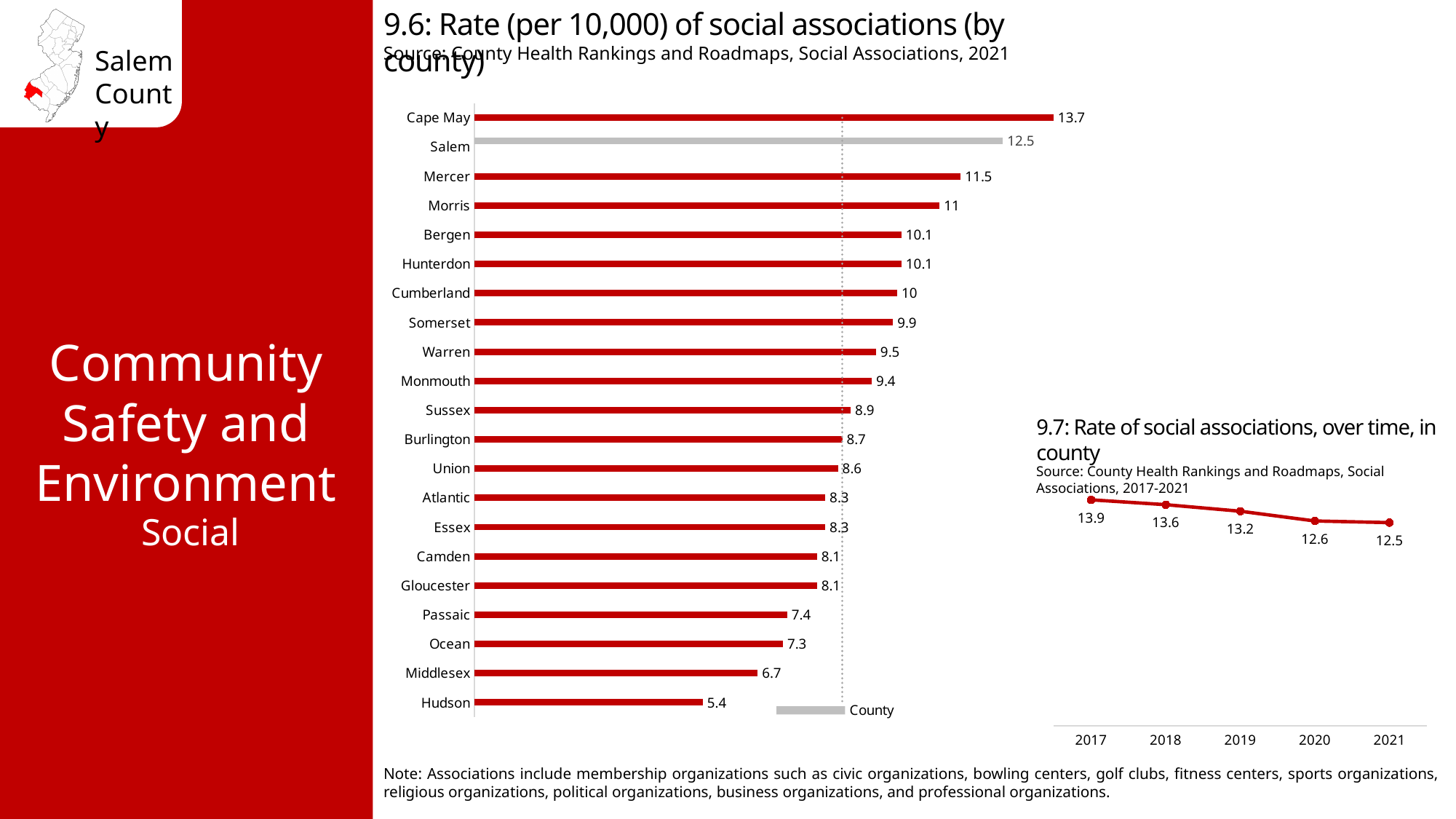
In chart 9.7, what is the difference between the 2017 and 2021 rates? 1.4 In chart 9.6, what colour is the bar for Salem? Grey In chart 9.7, does the rate of social associations rise or fall from 2017 to 2021? Fall In chart 9.6, how many counties are shown? 21 What kind of chart is chart 9.6? Bar chart In chart 9.6, what is the rate of social associations for Salem? 12.5 In chart 9.6, which county has the highest rate of social associations? Cape May In chart 9.6, what is the rate of social associations for Mercer? 11.5 In chart 9.6, which county has a higher rate, Morris or Bergen? Morris In chart 9.7, what was the rate of social associations in 2017? 13.9 In chart 9.6, which county has the lowest rate of social associations? Hudson In chart 9.6, what is the difference between the rates for Cape May and Salem? 1.2